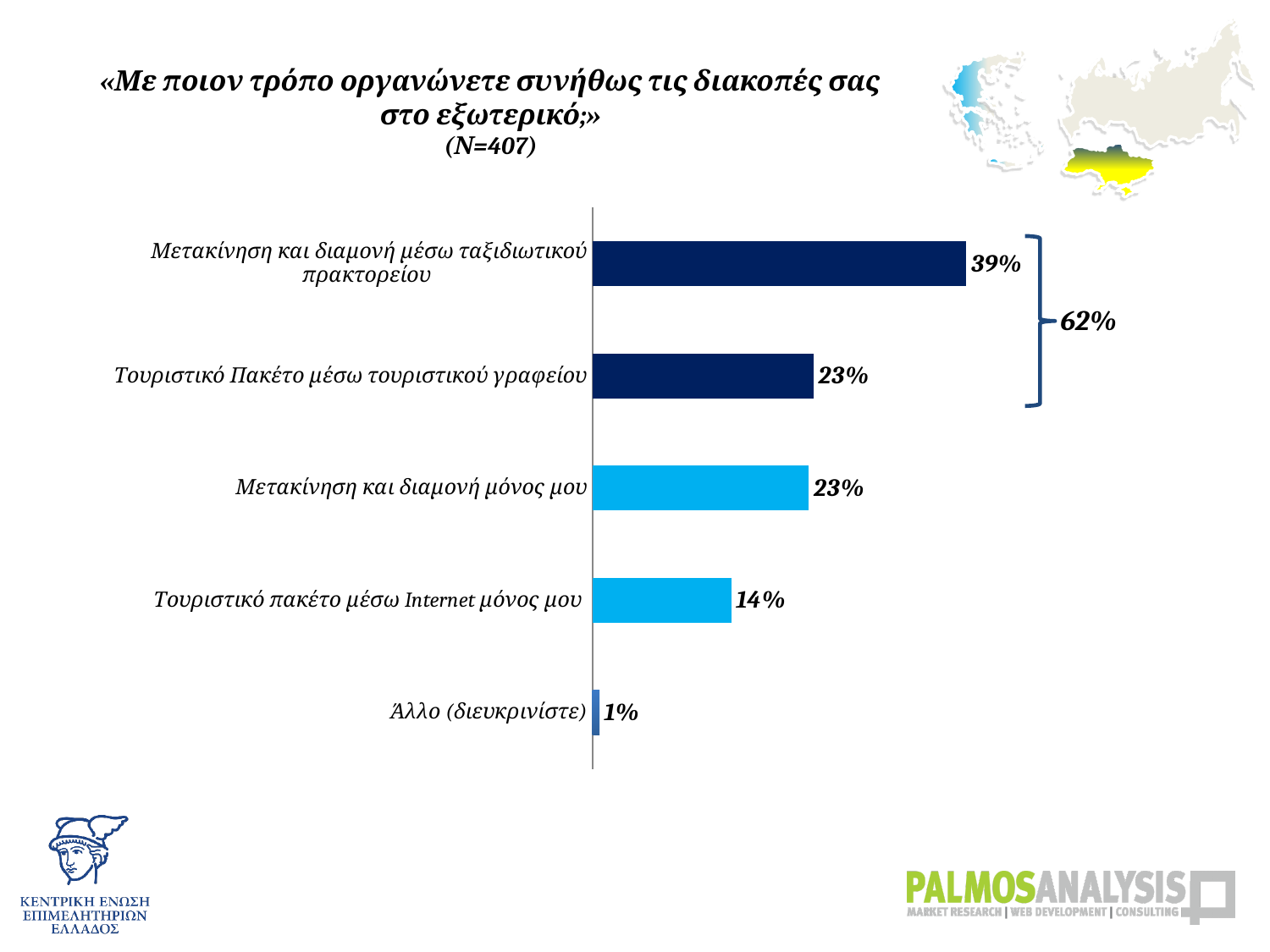
What is the difference between the values for «Μετακίνηση και διαμονή μέσω ταξιδιωτικού πρακτορείου» and «Τουριστικό Πακέτο μέσω τουριστικού γραφείου»? 16% What combined value does the bracket next to the first two bars show? 62% What kind of chart is shown on the slide? Bar chart What is the value for «Άλλο (διευκρινίστε)»? 1% Which is larger: the value for «Μετακίνηση και διαμονή μόνος μου» or the value for «Τουριστικό πακέτο μέσω Internet μόνος μου»? Μετακίνηση και διαμονή μόνος μου What sample size (N) is stated in the chart title? N=407 What is the value for «Μετακίνηση και διαμονή μέσω ταξιδιωτικού πρακτορείου»? 39% What is the value for «Μετακίνηση και διαμονή μόνος μου»? 23% Which category has the highest value? Μετακίνηση και διαμονή μέσω ταξιδιωτικού πρακτορείου Which category has the lowest value? Άλλο (διευκρινίστε) What is the value for «Τουριστικό πακέτο μέσω Internet μόνος μου»? 14% How many categories are shown in the chart? 5